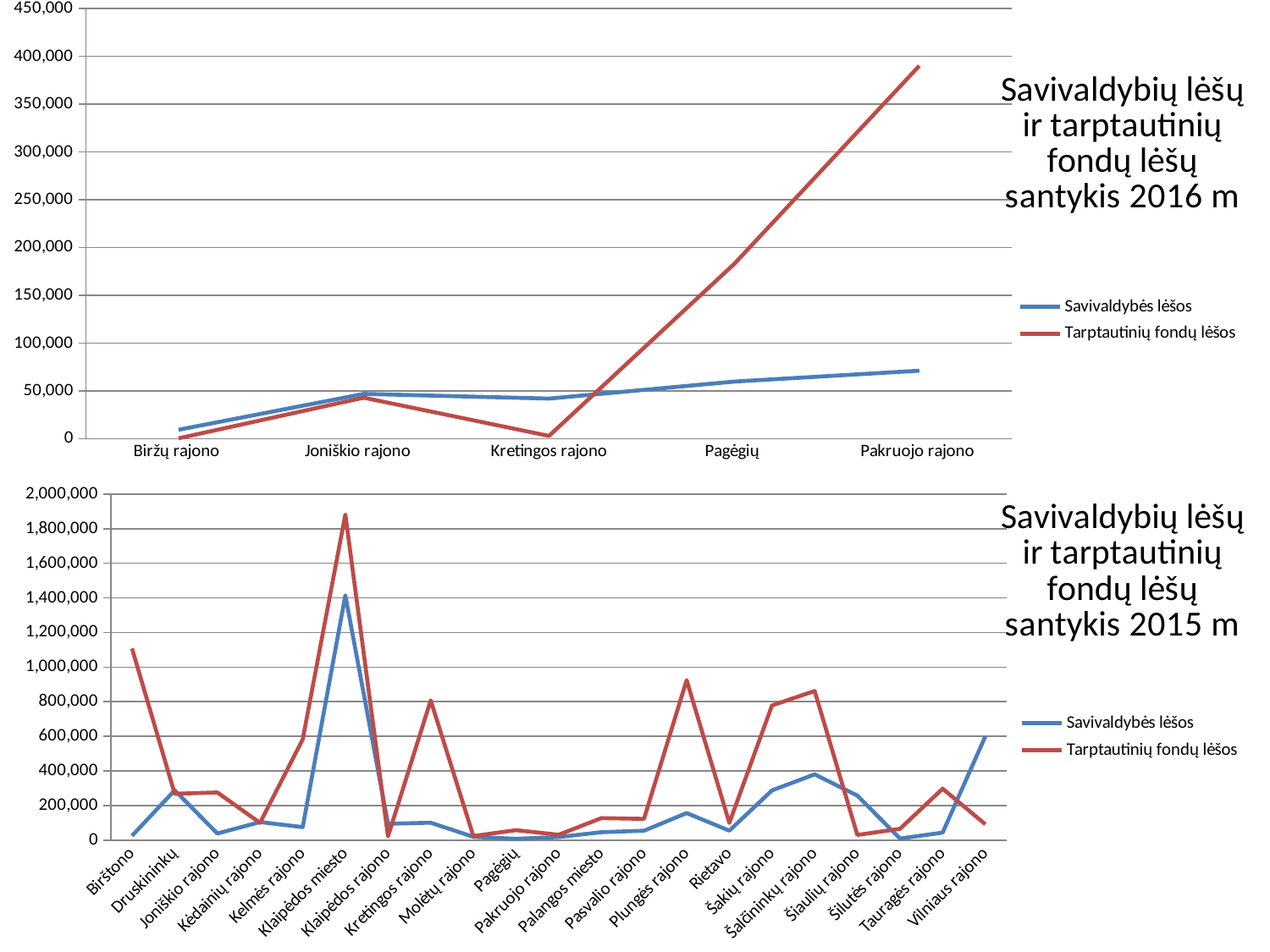
In the bottom chart (santykis 2015 m), is the value of Savivaldybės lėšos for Klaipėdos miesto greater or less than 1,200,000? greater In the bottom chart (santykis 2015 m), how many categories are shown on the x axis? 21 In the top chart (santykis 2016 m), how many categories are shown on the x axis? 5 In the bottom chart (santykis 2015 m), which category has the highest value for Tarptautinių fondų lėšos? Klaipėdos miesto In the top chart (santykis 2016 m), which category has the highest value for Tarptautinių fondų lėšos? Pakruojo rajono In the top chart (santykis 2016 m), which series has the larger value for Kretingos rajono? Savivaldybės lėšos In the top chart (santykis 2016 m), does the Savivaldybės lėšos line generally rise or fall from Biržų rajono to Pakruojo rajono? rise In the bottom chart (santykis 2015 m), what colour is the line for Tarptautinių fondų lėšos? red In the top chart (santykis 2016 m), what kind of chart is shown? line chart In the top chart (santykis 2016 m), is the value of Tarptautinių fondų lėšos for Pakruojo rajono greater or less than 350,000? greater In the bottom chart (santykis 2015 m), which series has the larger value for Birštono? Tarptautinių fondų lėšos In the top chart (santykis 2016 m), how many series does the legend list? 2